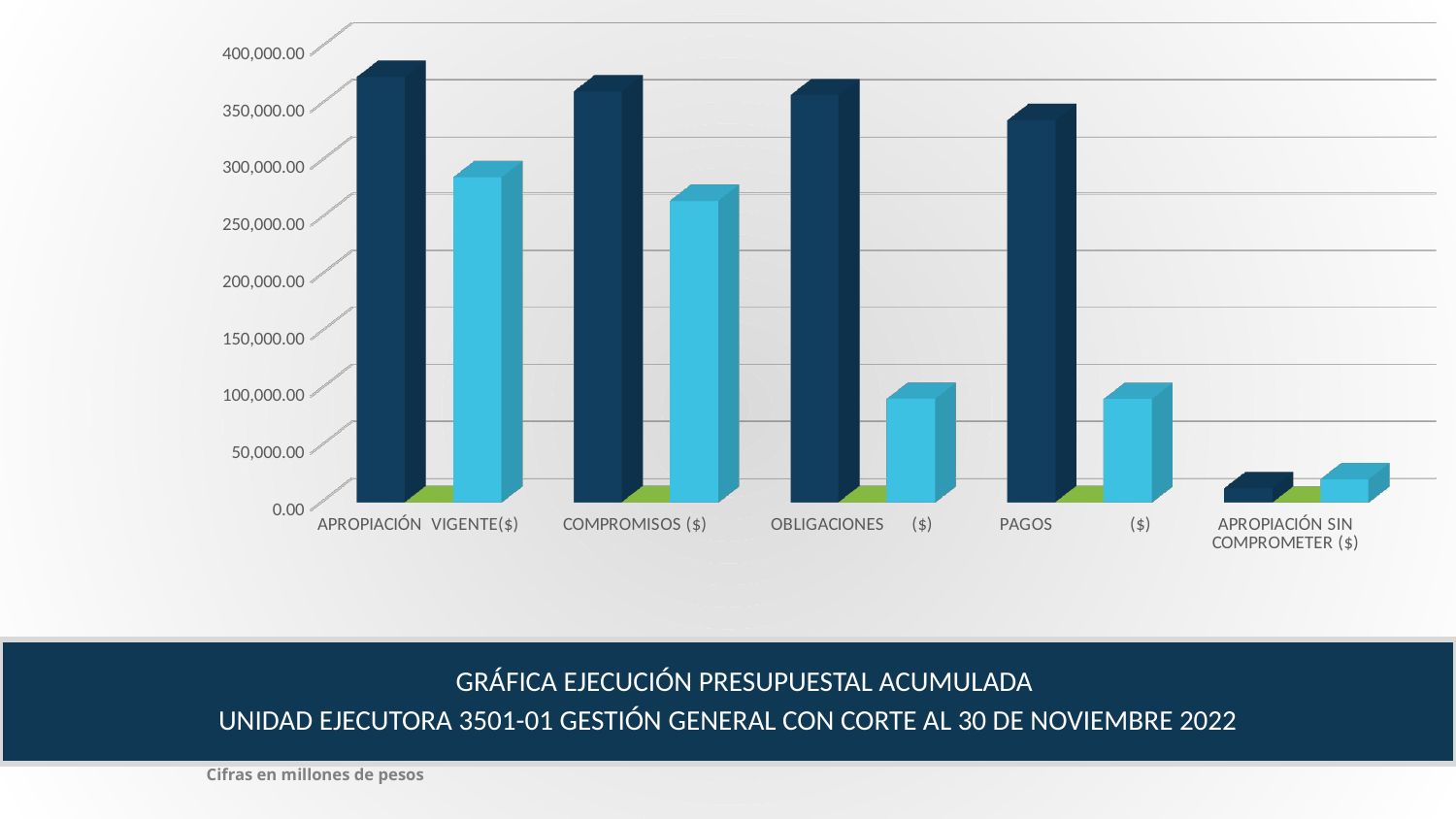
Is the dark blue bar for PAGOS ($) greater or less than 350,000.00? less Is the light blue bar for OBLIGACIONES ($) greater or less than 150,000.00? less Is the light blue bar for APROPIACIÓN VIGENTE($) greater or less than 300,000.00? less Which category has the tallest dark blue bar? APROPIACIÓN VIGENTE($) For OBLIGACIONES ($), which bar is taller, the dark blue bar or the light blue bar? The dark blue bar Which category has the shortest dark blue bar? APROPIACIÓN SIN COMPROMETER ($) What kind of chart is shown on the slide? Bar chart Do the dark blue bars rise or fall from left to right across the categories? Fall How many categories are shown along the x axis of the chart? 5 According to the note below the chart, in what units are the figures expressed? Millones de pesos